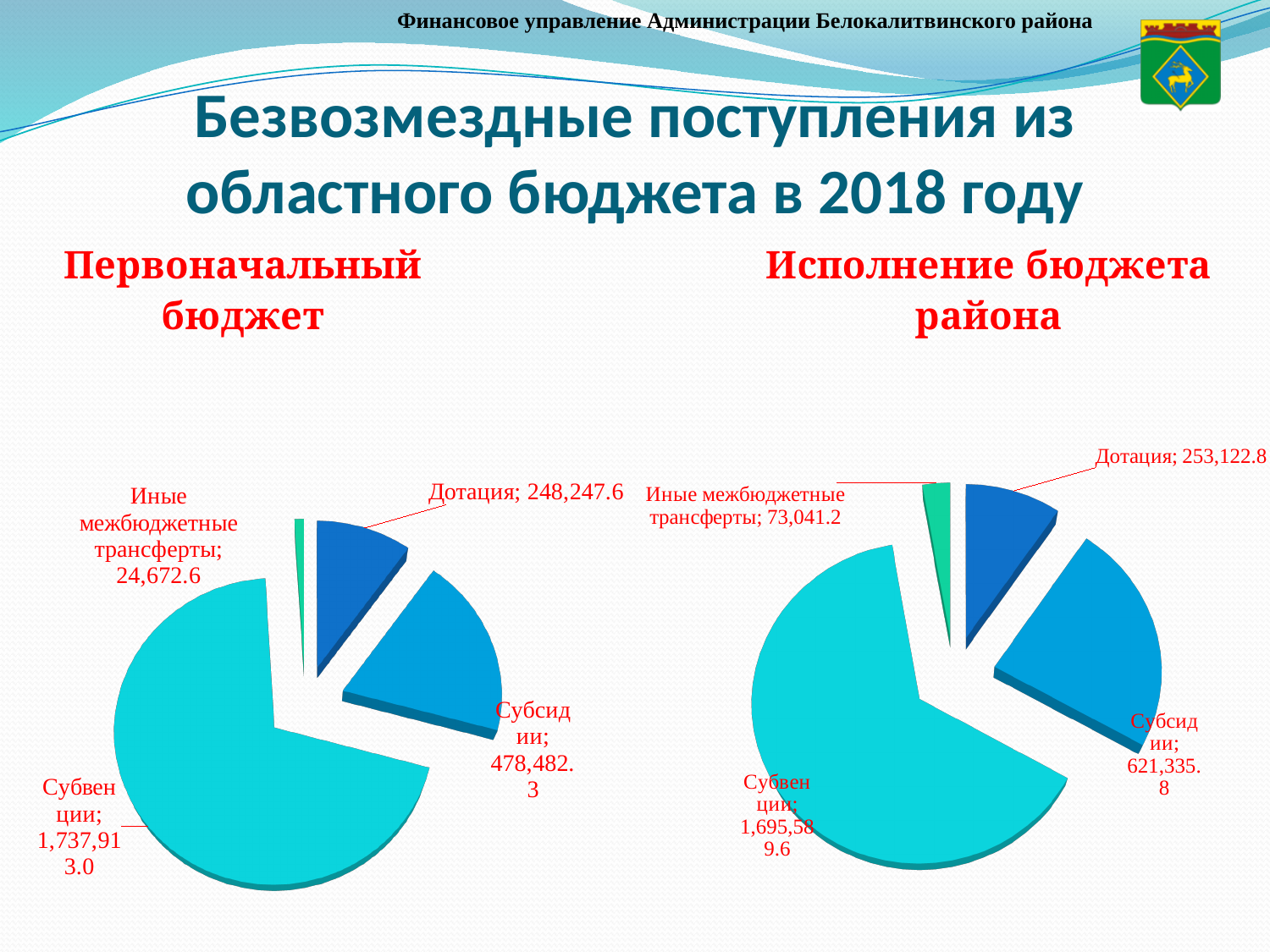
In the 'Исполнение бюджета района' chart, which category has the smallest slice? Иные межбюджетные трансферты Is the Субвенции value larger in the 'Первоначальный бюджет' chart or in the 'Исполнение бюджета района' chart? Первоначальный бюджет What is the difference between the Субсидии value in the 'Исполнение бюджета района' chart and the Субсидии value in the 'Первоначальный бюджет' chart? 142,853.5 In the 'Исполнение бюджета района' chart, what is the value for Субвенции? 1,695,589.6 How many categories are shown in the 'Исполнение бюджета района' chart? 4 In the 'Первоначальный бюджет' chart, what is the value for Иные межбюджетные трансферты? 24,672.6 In the 'Первоначальный бюджет' chart, which category has the largest slice? Субвенции What is the title of the chart on the right side of the slide? Исполнение бюджета района What type of chart is the 'Первоначальный бюджет' chart? Pie chart In the 'Исполнение бюджета района' chart, what is the value for Субсидии? 621,335.8 In the 'Первоначальный бюджет' chart, what is the value for Дотация? 248,247.6 In the 'Первоначальный бюджет' chart, what is the difference between Субсидии and Дотация? 230,234.7